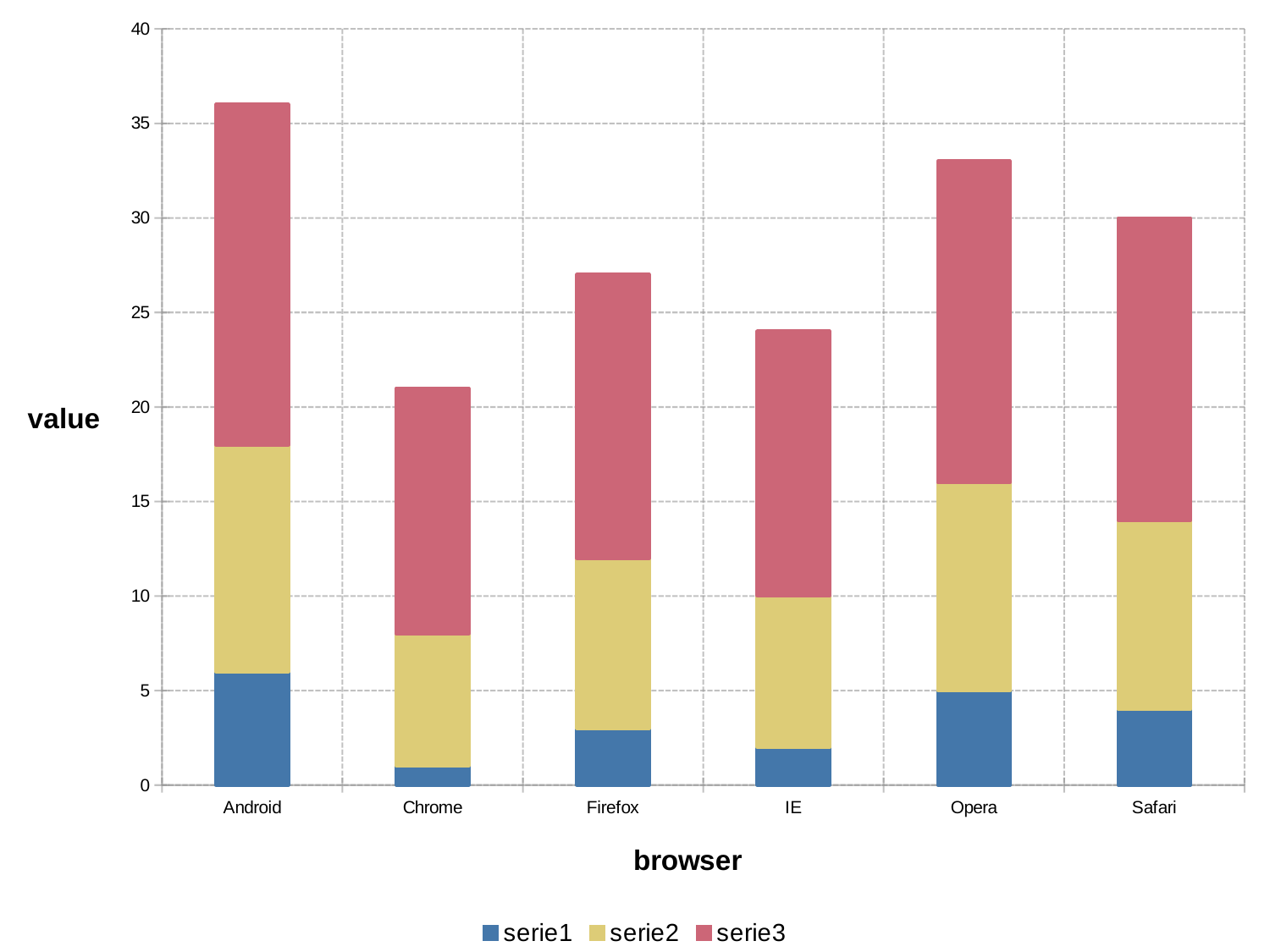
Which has the taller total bar, Opera or Safari? Opera Which browser has the smallest serie1 segment? Chrome Which browser has the tallest stacked bar overall? Android How many browser categories are shown on the x axis? 6 Is the total stacked value for Chrome greater or less than 25? less How many series does the legend list? 3 Which browser has the shortest stacked bar overall? Chrome What kind of chart is shown on the slide? stacked bar chart Is the total stacked value for IE greater or less than 20? greater Which has the larger serie1 segment, Android or Chrome? Android What is the title of the x axis? browser Is the total stacked value for Android greater or less than 30? greater